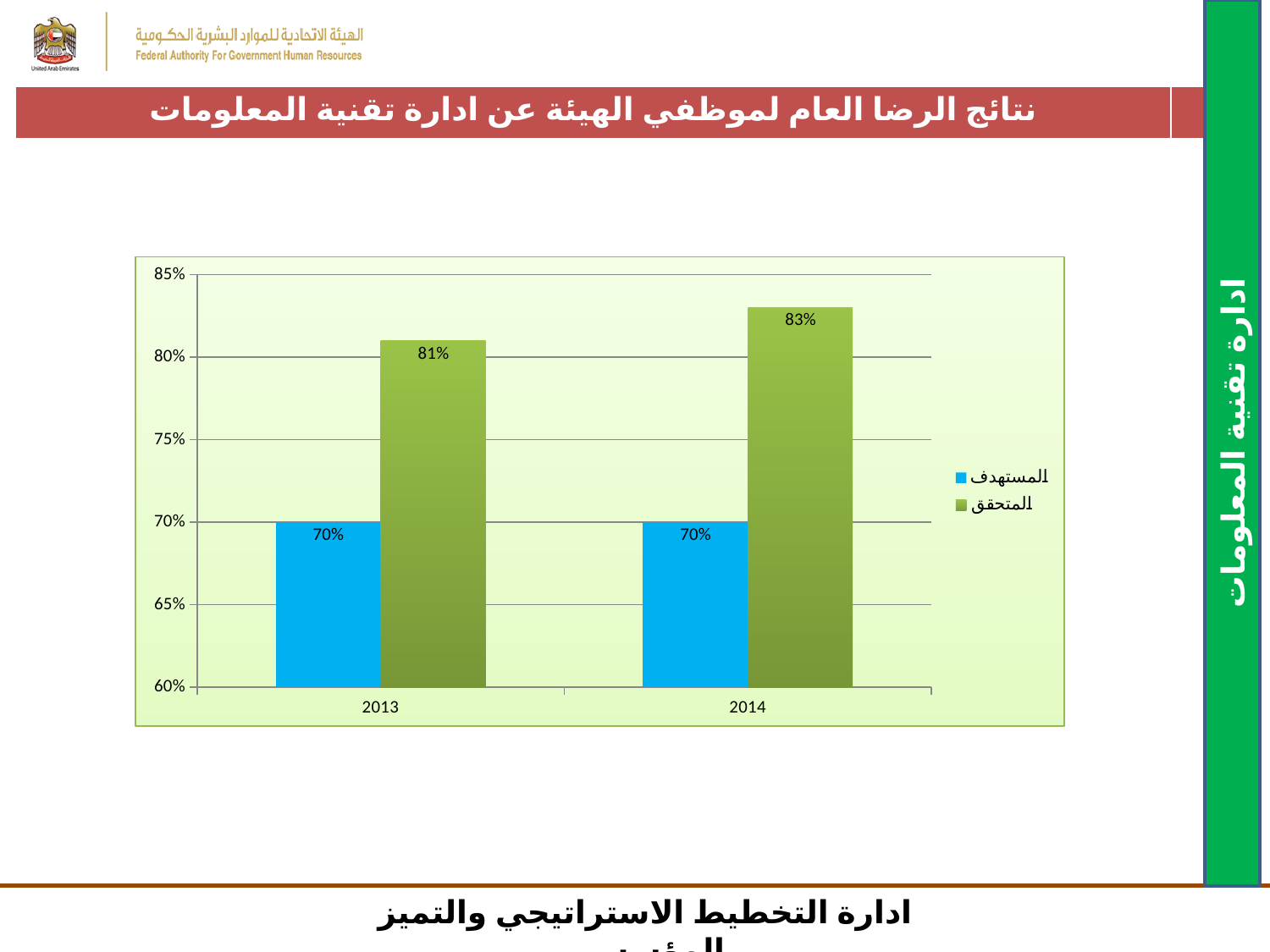
What is the difference between the المتحقق (achieved) values for 2014 and 2013? 2% How many series does the legend list? 2 In which year is the المتحقق (achieved) value highest? 2014 What kind of chart is shown on the slide? Bar chart Is the المتحقق (achieved) value for 2013 greater or less than 80%? greater What is the difference between the المتحقق (achieved) value and the المستهدف (target) value in 2014? 13% Does the المتحقق (achieved) value rise or fall from 2013 to 2014? Rise Which is larger in 2013: المستهدف (target) or المتحقق (achieved)? المتحقق What is the value of المستهدف (target) for 2014? 70% What is the value of المتحقق (achieved) for 2013? 81% How many years are shown on the x axis? 2 What is the value of المتحقق (achieved) for 2014? 83%